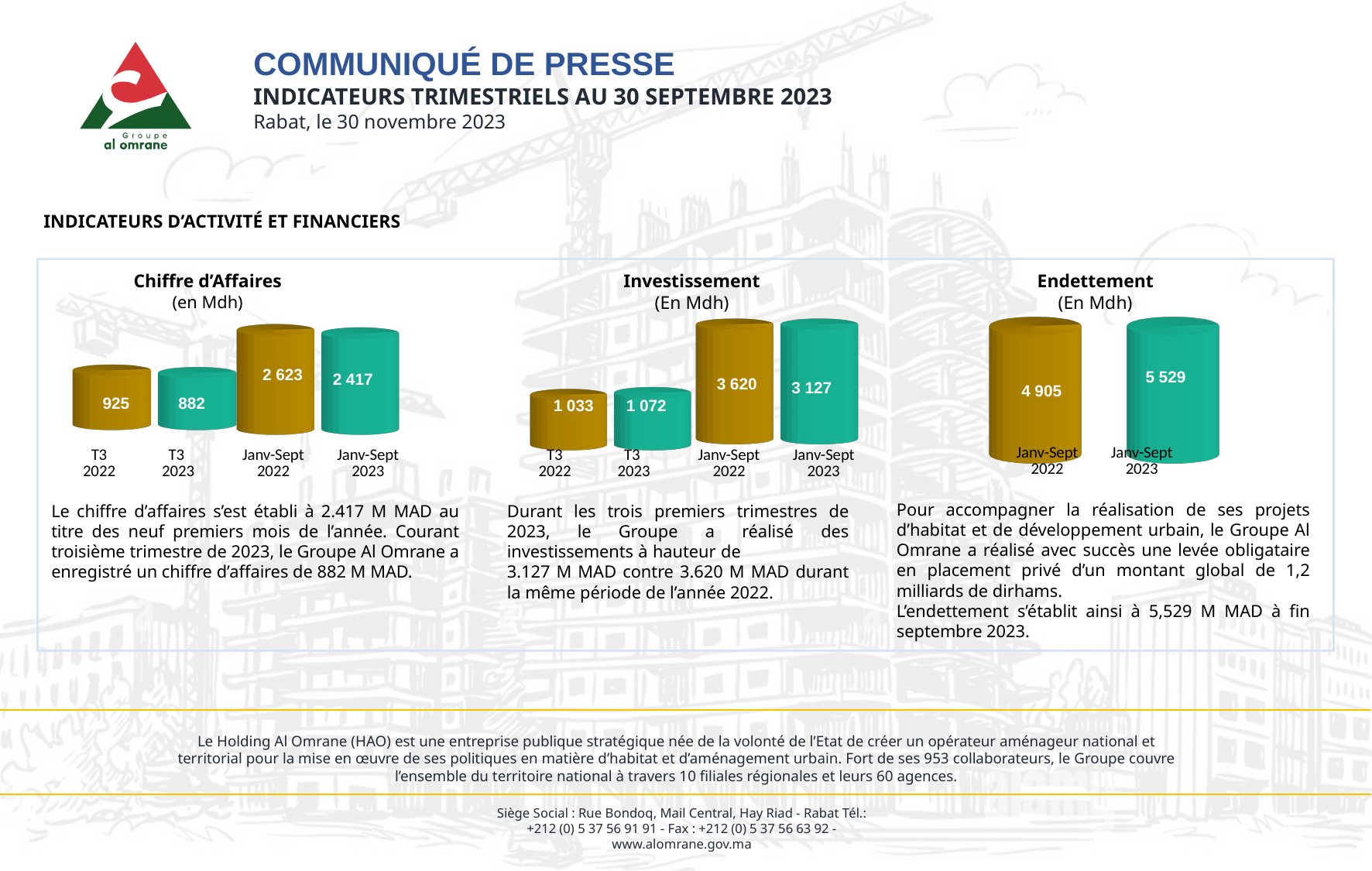
In the Endettement chart, what is the value for Janv-Sept 2023? 5 529 In the Investissement chart, what is the value for Janv-Sept 2022? 3 620 In the Chiffre d'Affaires chart, which category has the highest value? Janv-Sept 2022 In the Chiffre d'Affaires chart, what is the value for T3 2023? 882 In the Chiffre d'Affaires chart, what is the difference between Janv-Sept 2022 and Janv-Sept 2023? 206 In the Investissement chart, how many categories are shown? 4 In the Investissement chart, what is the difference between Janv-Sept 2022 and Janv-Sept 2023? 493 What kind of chart is the Endettement chart? Bar chart In the Chiffre d'Affaires chart, what is the value for Janv-Sept 2023? 2 417 In the Endettement chart, which is larger, Janv-Sept 2022 or Janv-Sept 2023? Janv-Sept 2023 In the Investissement chart, which category has the lowest value? T3 2022 In the Endettement chart, what is the difference between Janv-Sept 2023 and Janv-Sept 2022? 624